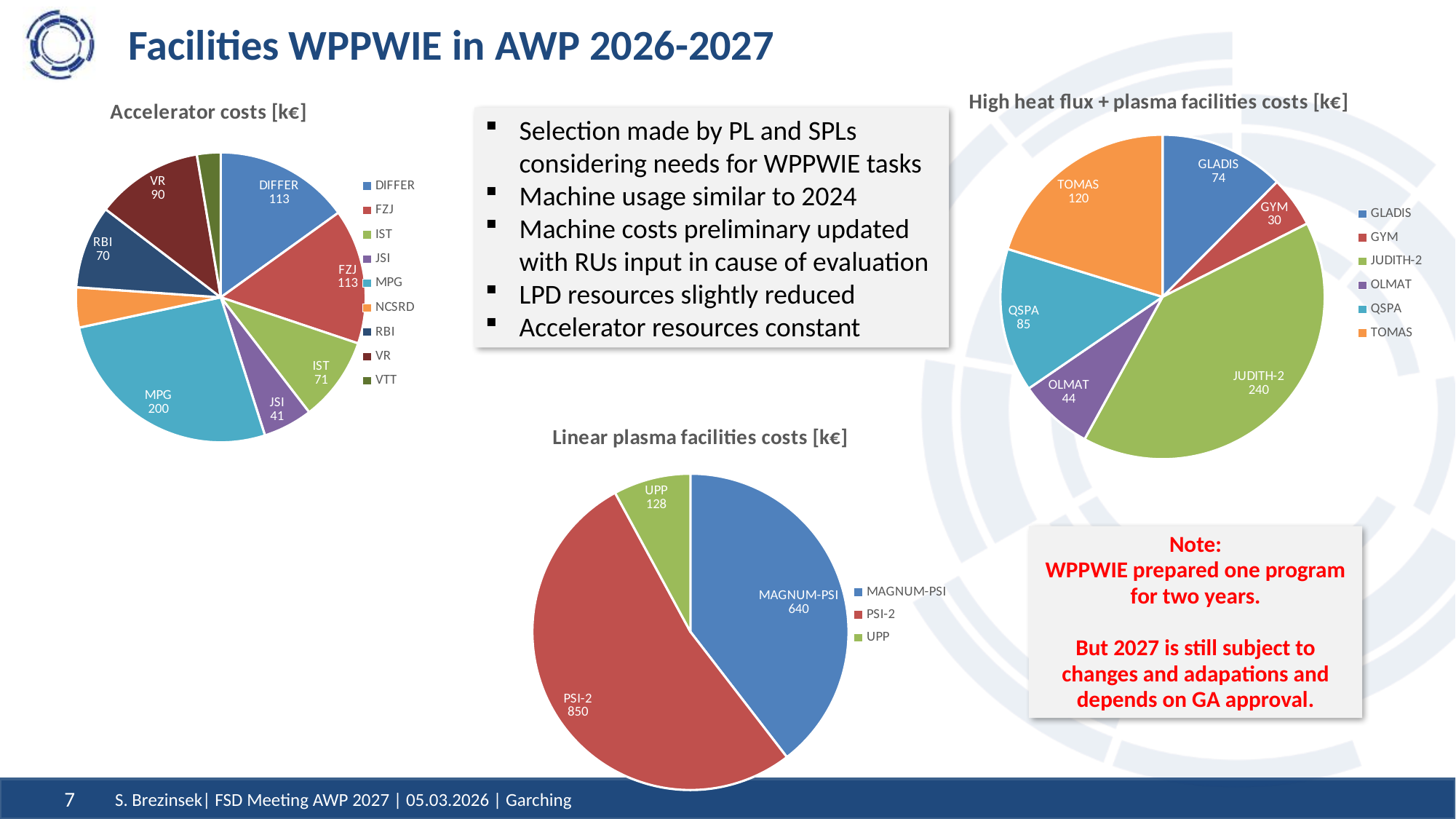
In the Accelerator costs [k€] chart, which category has the largest slice? MPG What type of chart is the Linear plasma facilities costs [k€] chart? Pie chart In the Linear plasma facilities costs [k€] chart, what is the value for PSI-2? 850 In the High heat flux + plasma facilities costs [k€] chart, what is the difference between JUDITH-2 and OLMAT? 196 How many categories are shown in the High heat flux + plasma facilities costs [k€] chart? 6 In the Accelerator costs [k€] chart, what is the value for MPG? 200 In the High heat flux + plasma facilities costs [k€] chart, which is larger, QSPA or GLADIS? QSPA In the Accelerator costs [k€] chart, what is the difference between the values for VR and RBI? 20 In the Linear plasma facilities costs [k€] chart, what is the difference between PSI-2 and MAGNUM-PSI? 210 In the High heat flux + plasma facilities costs [k€] chart, which category has the smallest value? GYM How many entries does the legend of the Accelerator costs [k€] chart list? 9 In the High heat flux + plasma facilities costs [k€] chart, what is the value for TOMAS? 120